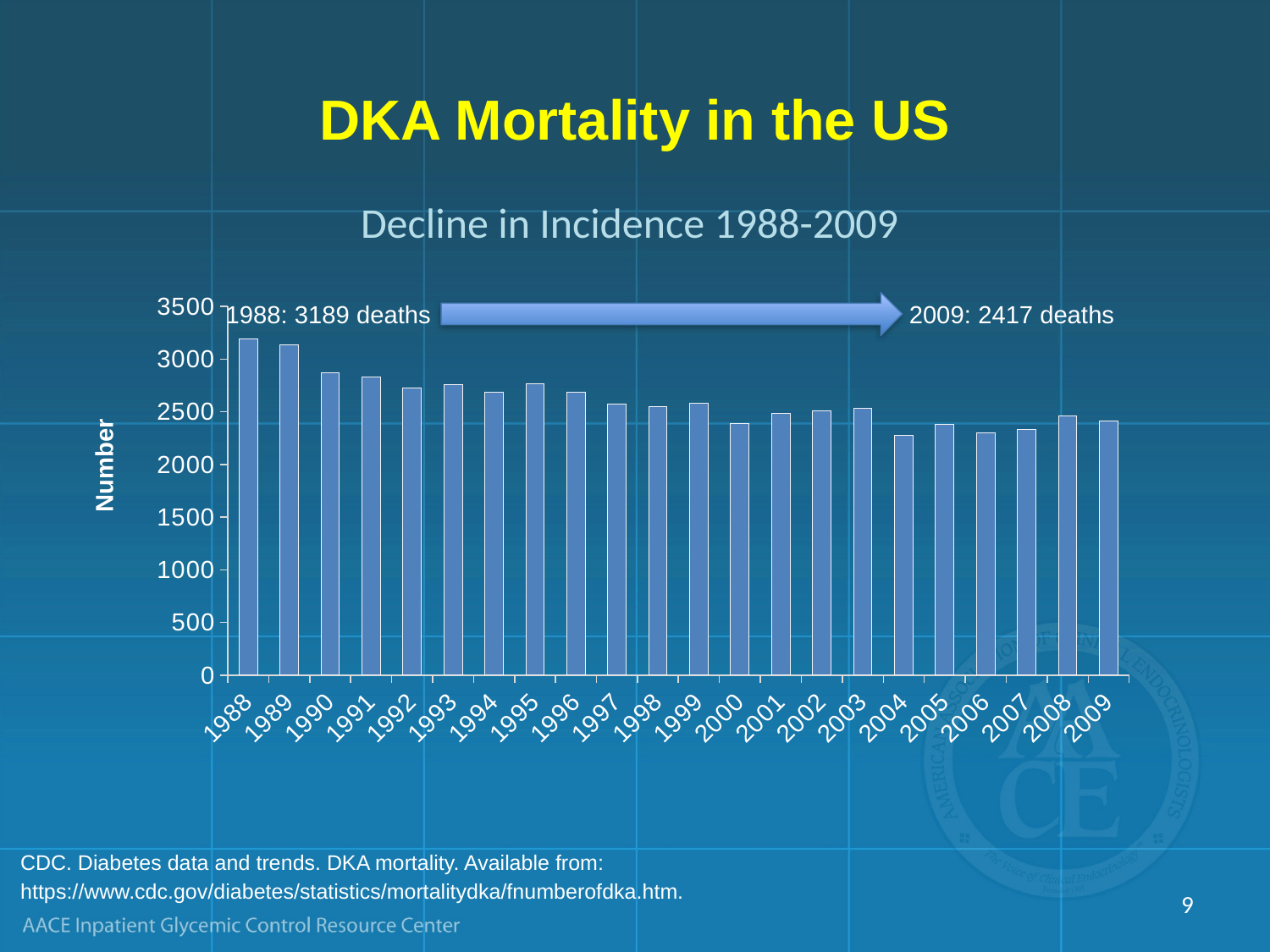
Which year has more DKA deaths, 1990 or 2000? 1990 By how much did the number of DKA deaths fall from 1988 to 2009? 772 Is the value for 1995 greater or less than 2500? greater What kind of chart is shown on the slide? Bar chart Which year has the highest number of DKA deaths? 1988 How many years are plotted on the x axis? 22 How many DKA deaths were there in 1988 according to the chart annotation? 3189 What is the label on the y axis of the chart? Number Is the value for 2004 greater or less than 2500? less How many DKA deaths were there in 2009 according to the chart annotation? 2417 Do the values generally rise or fall from 1988 to 2009? Fall Is the value for 1990 greater or less than 3000? less